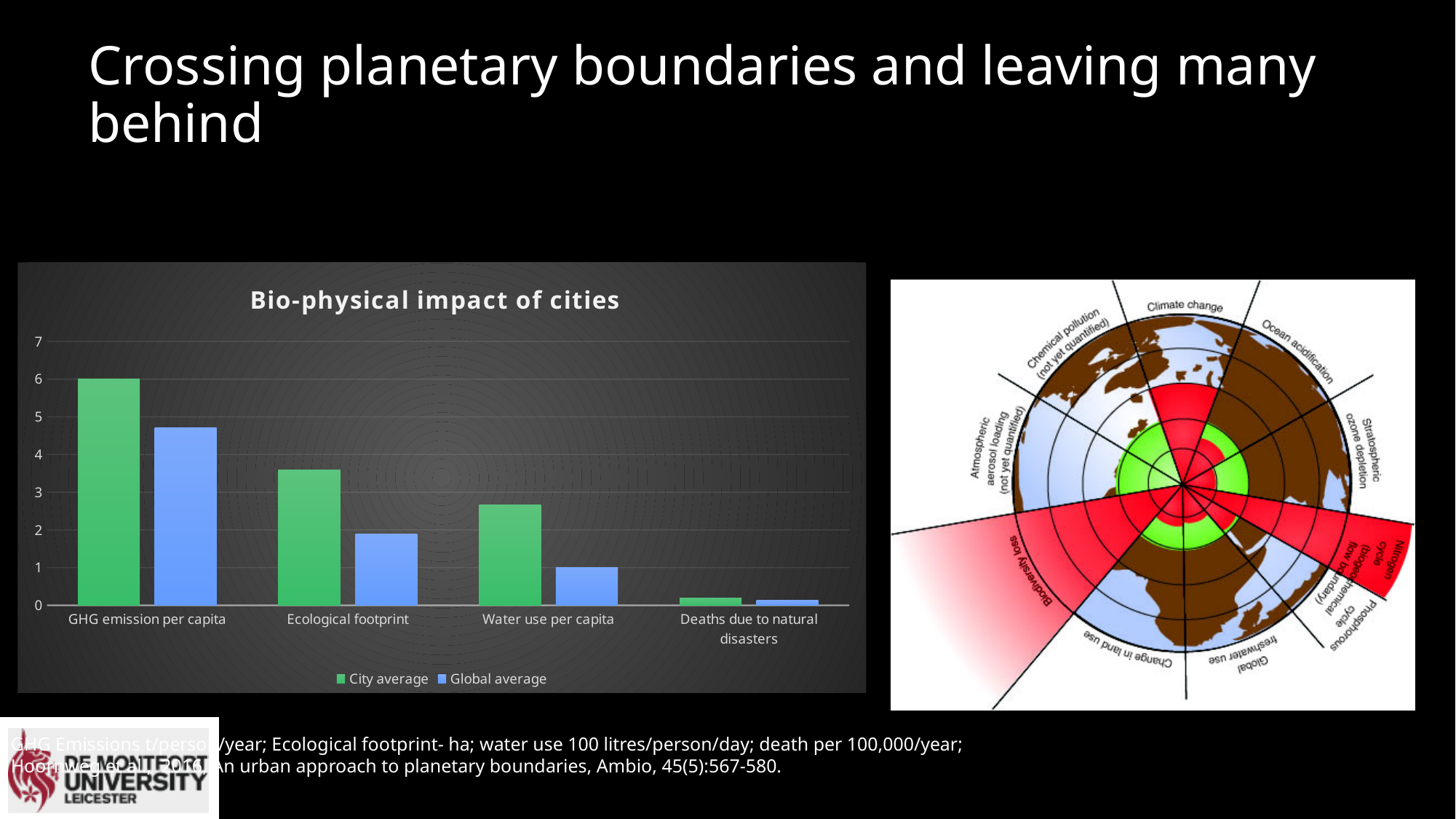
What kind of chart is the 'Bio-physical impact of cities' chart? bar chart In the 'Bio-physical impact of cities' chart, which category has the highest City average value? GHG emission per capita Do the City average values in the 'Bio-physical impact of cities' chart rise or fall from left to right along the x axis? fall In the 'Bio-physical impact of cities' chart, is the City average value for Ecological footprint greater or less than 3? greater How many series does the legend of the 'Bio-physical impact of cities' chart list? 2 In the 'Bio-physical impact of cities' chart, which is larger for GHG emission per capita: City average or Global average? City average In the 'Bio-physical impact of cities' chart, is the Global average value for GHG emission per capita greater or less than 4? greater How many categories are shown on the x axis of the 'Bio-physical impact of cities' chart? 4 In the 'Bio-physical impact of cities' chart, is the City average value for Water use per capita greater or less than 3? less What colour represents the City average series in the 'Bio-physical impact of cities' chart? green In the 'Bio-physical impact of cities' chart, which category has the lowest Global average value? Deaths due to natural disasters